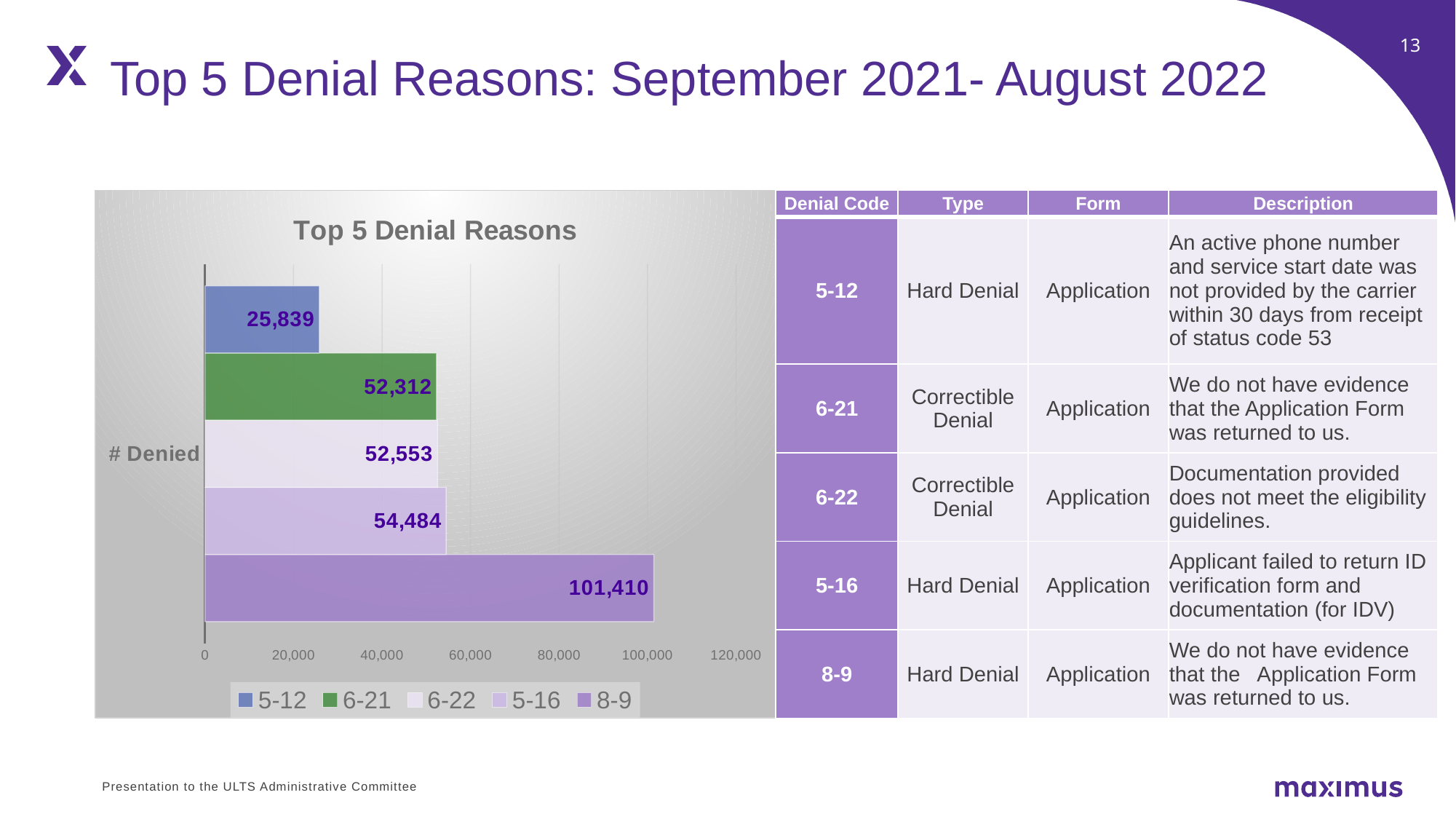
What is the axis label shown on the left side of the chart? # Denied Which denial code has the highest number denied in the chart? 8-9 Which has a larger value, denial code 8-9 or denial code 5-16? 8-9 What is the difference between the values for denial codes 5-16 and 6-22? 1,931 Is the value for denial code 8-9 greater or less than 80,000? greater What is the difference between the values for denial codes 8-9 and 5-12? 75,571 How many denial codes are plotted in the chart? 5 Which denial code has the lowest number denied in the chart? 5-12 What is the value for denial code 5-12 in the Top 5 Denial Reasons chart? 25,839 What is the value for denial code 5-16 in the Top 5 Denial Reasons chart? 54,484 What is the value for denial code 8-9 in the Top 5 Denial Reasons chart? 101,410 What kind of chart is used to show the Top 5 Denial Reasons? Bar chart